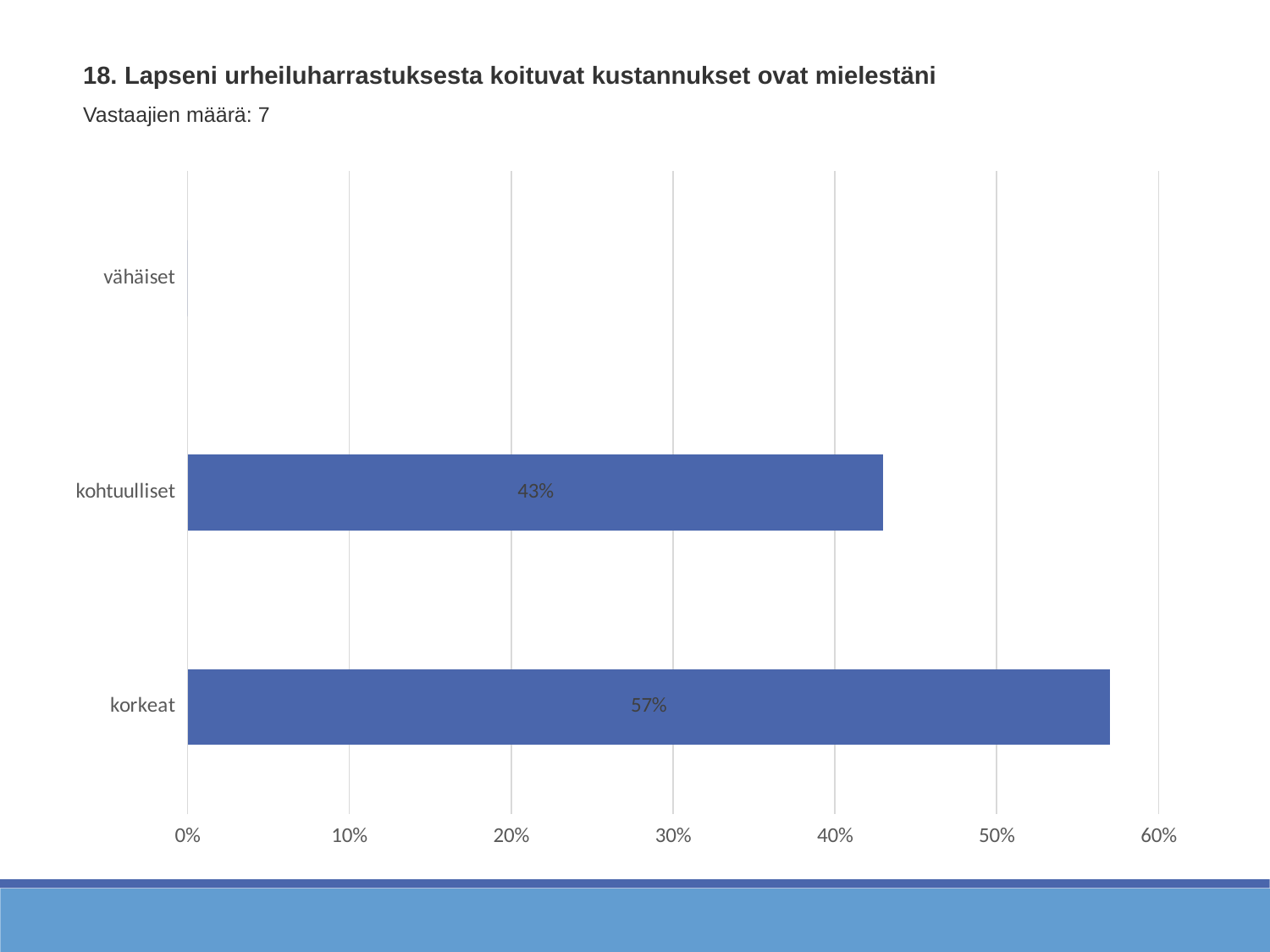
Which category has the lowest value? vähäiset What is the total of the values for korkeat and kohtuulliset? 100% How many respondents (Vastaajien määrä) are stated on the slide? 7 What is the difference between the values for korkeat and kohtuulliset? 14% What is the value for kohtuulliset? 43% How many categories are shown on the chart? 3 What is the value for korkeat? 57% Which category has the highest value? korkeat Is the value for korkeat greater or less than 50%? greater What kind of chart is shown on the slide? bar chart Is the value for kohtuulliset greater or less than 50%? less Which is larger, the value for korkeat or the value for kohtuulliset? korkeat